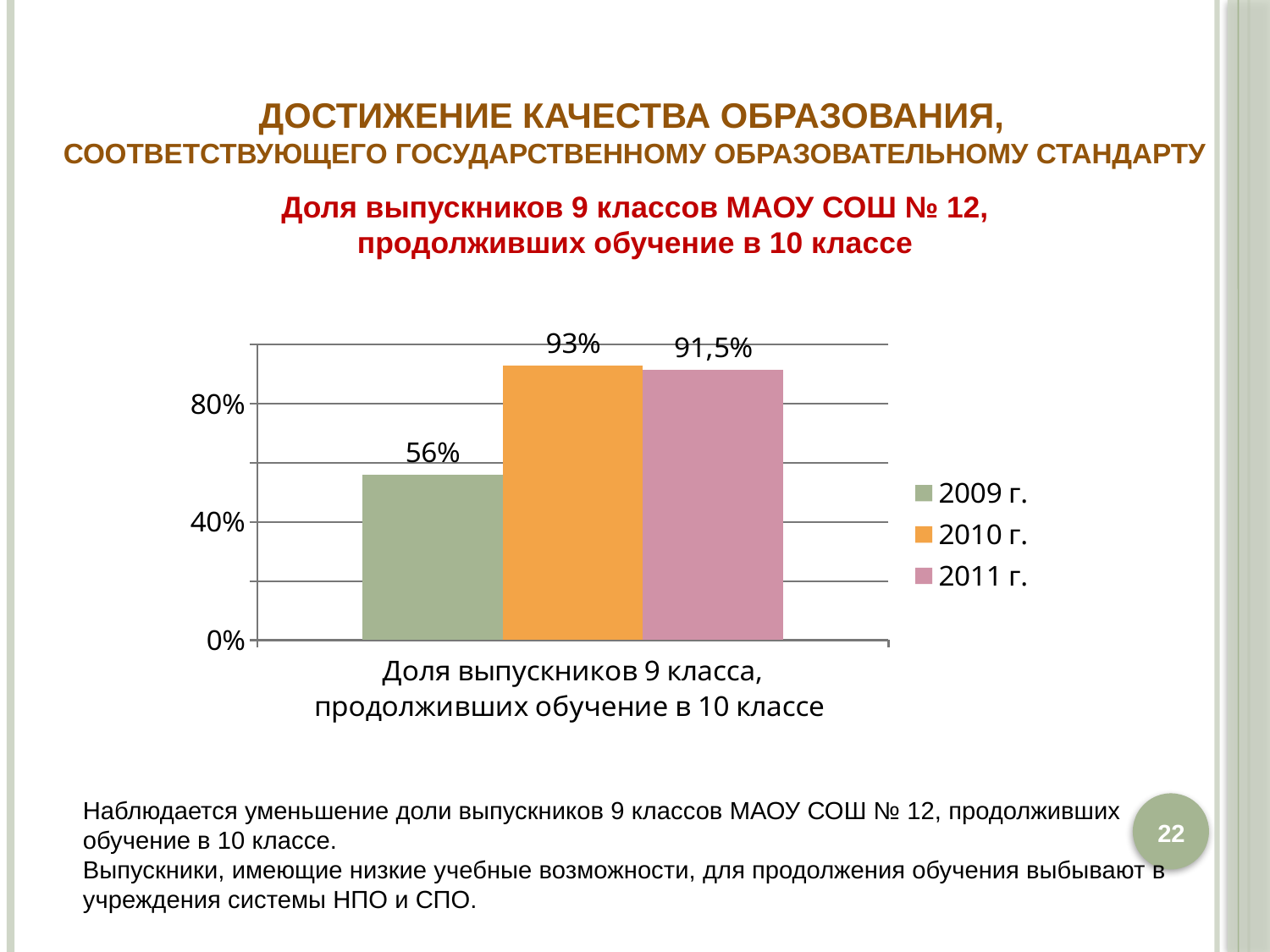
What kind of chart is shown on the slide? bar chart What is the value for 2010 г.? 93% Which year has the lowest value? 2009 г. What is the value for 2011 г.? 91,5% What is the difference between the values for 2010 г. and 2009 г.? 37% Which is larger, the value for 2009 г. or the value for 2011 г.? 2011 г. What is the difference between the values for 2010 г. and 2011 г.? 1,5% How many series does the legend list? 3 Is the value for 2009 г. greater or less than 80%? less Which year has the highest value? 2010 г. What colour is the bar for 2010 г.? orange What is the value for 2009 г.? 56%